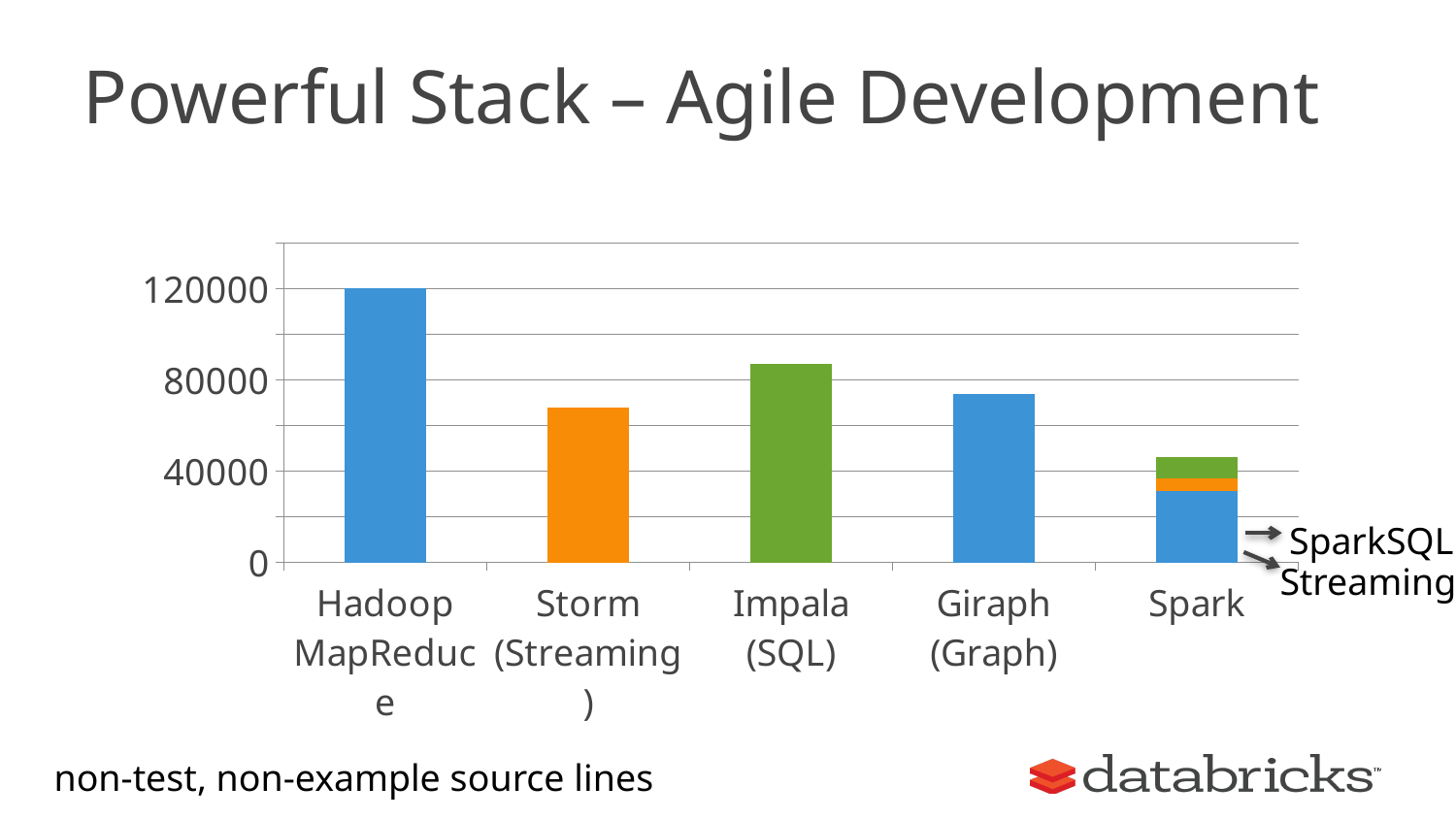
Which category has the lowest bar in the chart? Spark Is the value for Storm (Streaming) greater or less than 80000? less How many categories are shown on the x axis of the chart? 5 Is the value for Giraph (Graph) greater or less than 80000? less Is the total value for Spark greater or less than 40000? greater Which is larger, the bar for Impala (SQL) or the bar for Giraph (Graph)? Impala (SQL) What value does the Hadoop MapReduce bar reach on the y axis? 120000 Which is larger, the bar for Storm (Streaming) or the bar for Impala (SQL)? Impala (SQL) Which category has the highest bar in the chart? Hadoop MapReduce What kind of chart is shown on the slide? bar chart Which category's bar is split into multiple coloured segments? Spark